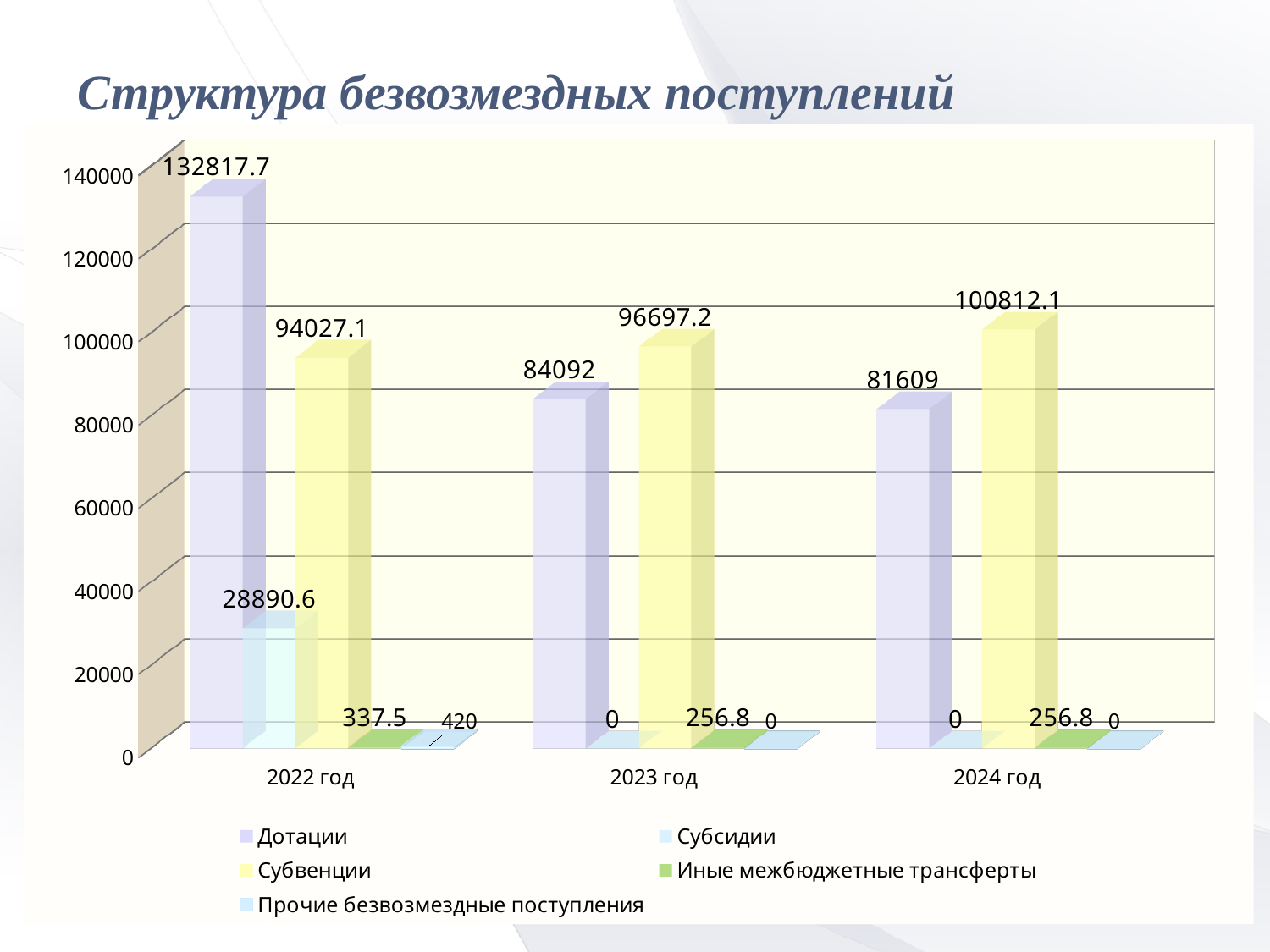
In which year is the value of Дотации the highest? 2022 год What is the value of Иные межбюджетные трансферты for 2023 год? 256.8 In which year is the value of Субвенции the lowest? 2022 год What kind of chart is shown on the slide? Bar chart Which is larger in 2023 год: Дотации or Субвенции? Субвенции How many series does the legend list? 5 What is the value of Дотации for 2022 год? 132817.7 What is the value of Субсидии for 2022 год? 28890.6 What is the value of Субвенции for 2024 год? 100812.1 How many years are shown on the x axis? 3 Does the value of Дотации rise or fall from 2022 год to 2024 год? Fall What is the difference between Дотации in 2022 год and 2023 год? 48725.7